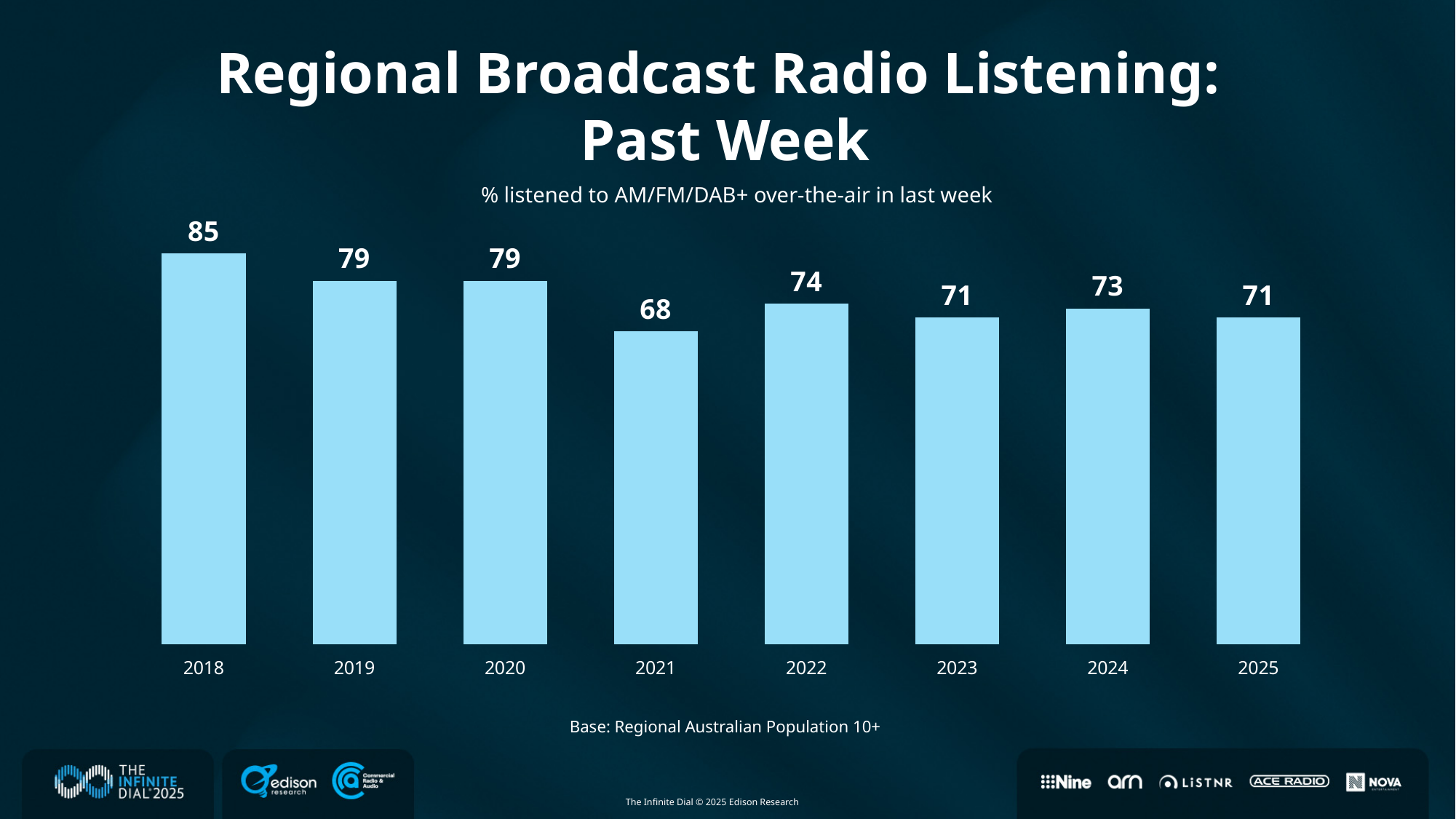
Which year has the highest value? 2018 How many years are shown on the chart? 8 What is the value for 2018? 85 Do the values generally rise or fall from 2018 to 2025? Fall What is the difference between the values for 2022 and 2021? 6 What kind of chart is shown on the slide? Bar chart Which year has the lowest value? 2021 What is the value for 2021? 68 What is the value for 2025? 71 What is the title of the chart? Regional Broadcast Radio Listening: Past Week Which is larger, the value for 2022 or the value for 2023? 2022 What is the difference between the values for 2018 and 2025? 14